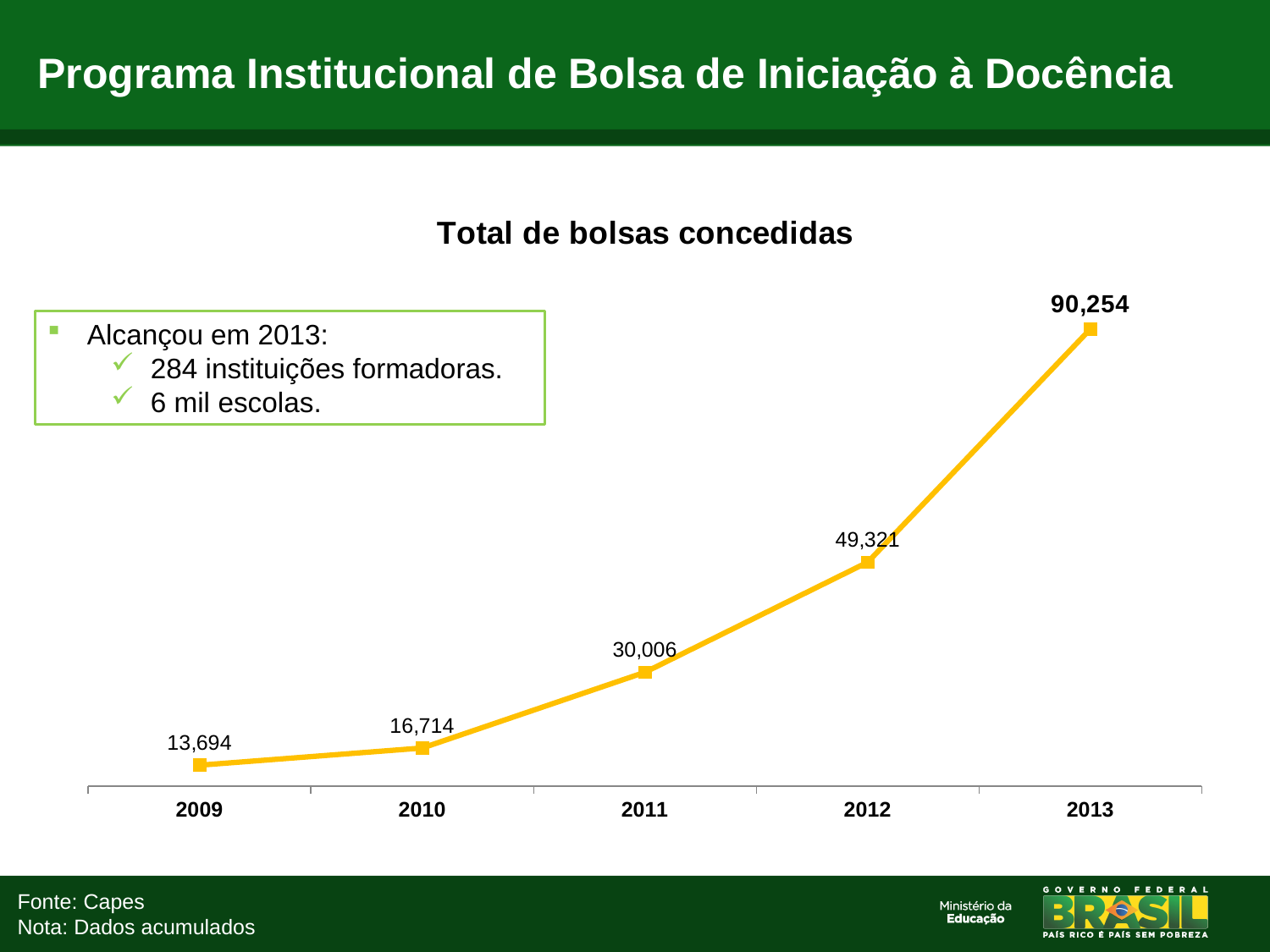
What kind of chart is shown? Line chart Which year has the lowest value? 2009 Which year has the highest value? 2013 What is the difference between the values for 2010 and 2009? 3,020 What is the value for 2012? 49,321 Which is larger, the value for 2011 or the value for 2010? 2011 Do the values rise or fall from 2009 to 2013? Rise How many years are plotted on the x axis? 5 What is the value for 2009? 13,694 What is the value for 2013? 90,254 What is the value for 2011? 30,006 What is the difference between the values for 2013 and 2012? 40,933